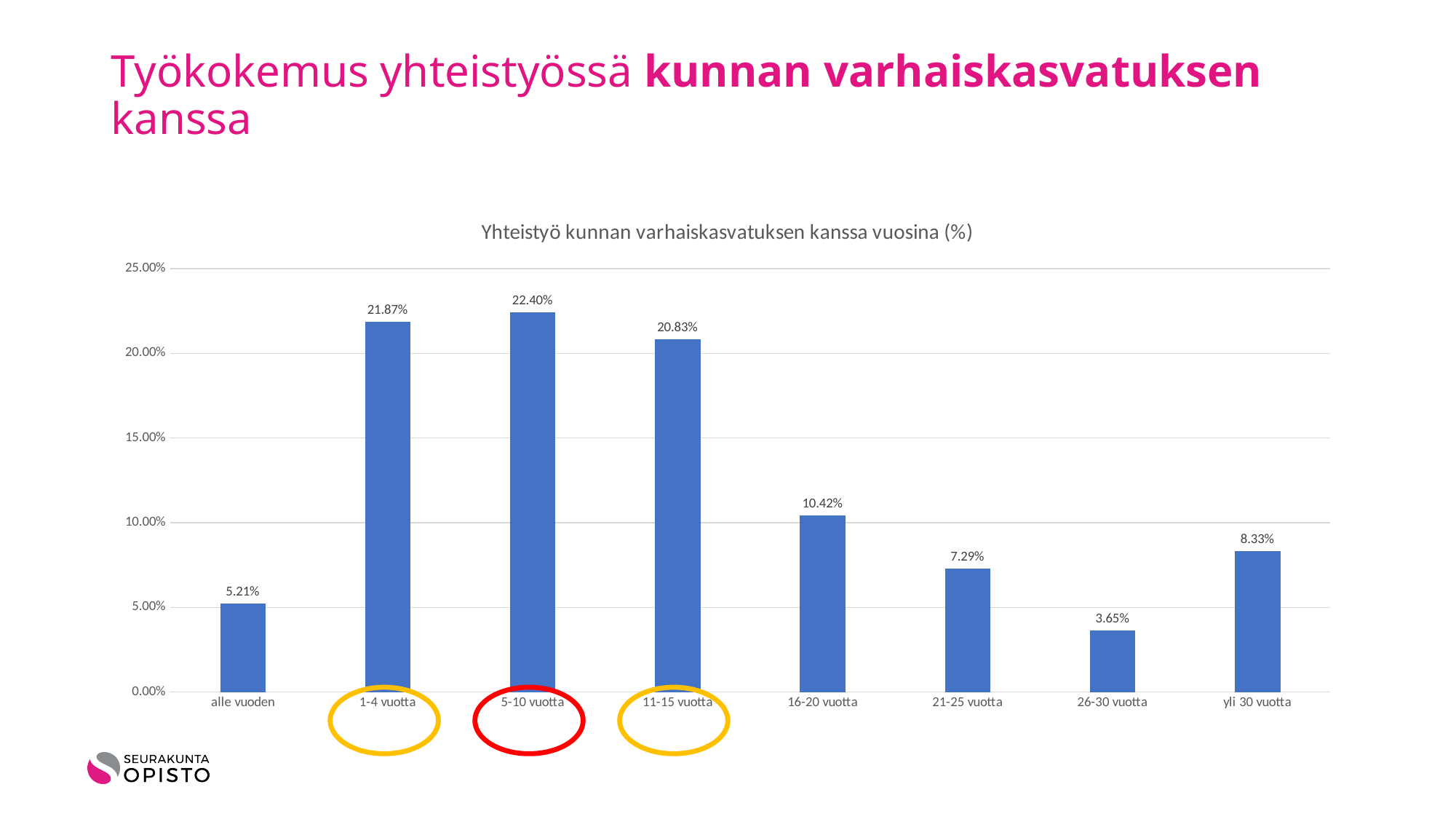
What is the difference between the values for 16-20 vuotta and 21-25 vuotta? 3.13% Which category has the highest value? 5-10 vuotta What is the value for 5-10 vuotta? 22.40% Which category has the lowest value? 26-30 vuotta Is the value for 16-20 vuotta greater or less than 10.00%? greater What is the value for alle vuoden? 5.21% Which category label is circled in red? 5-10 vuotta What is the title of the chart? Yhteistyö kunnan varhaiskasvatuksen kanssa vuosina (%) Which is larger, the value for 1-4 vuotta or the value for 11-15 vuotta? 1-4 vuotta How many categories are shown on the x axis? 8 What is the value for yli 30 vuotta? 8.33% What kind of chart is shown on the slide? bar chart